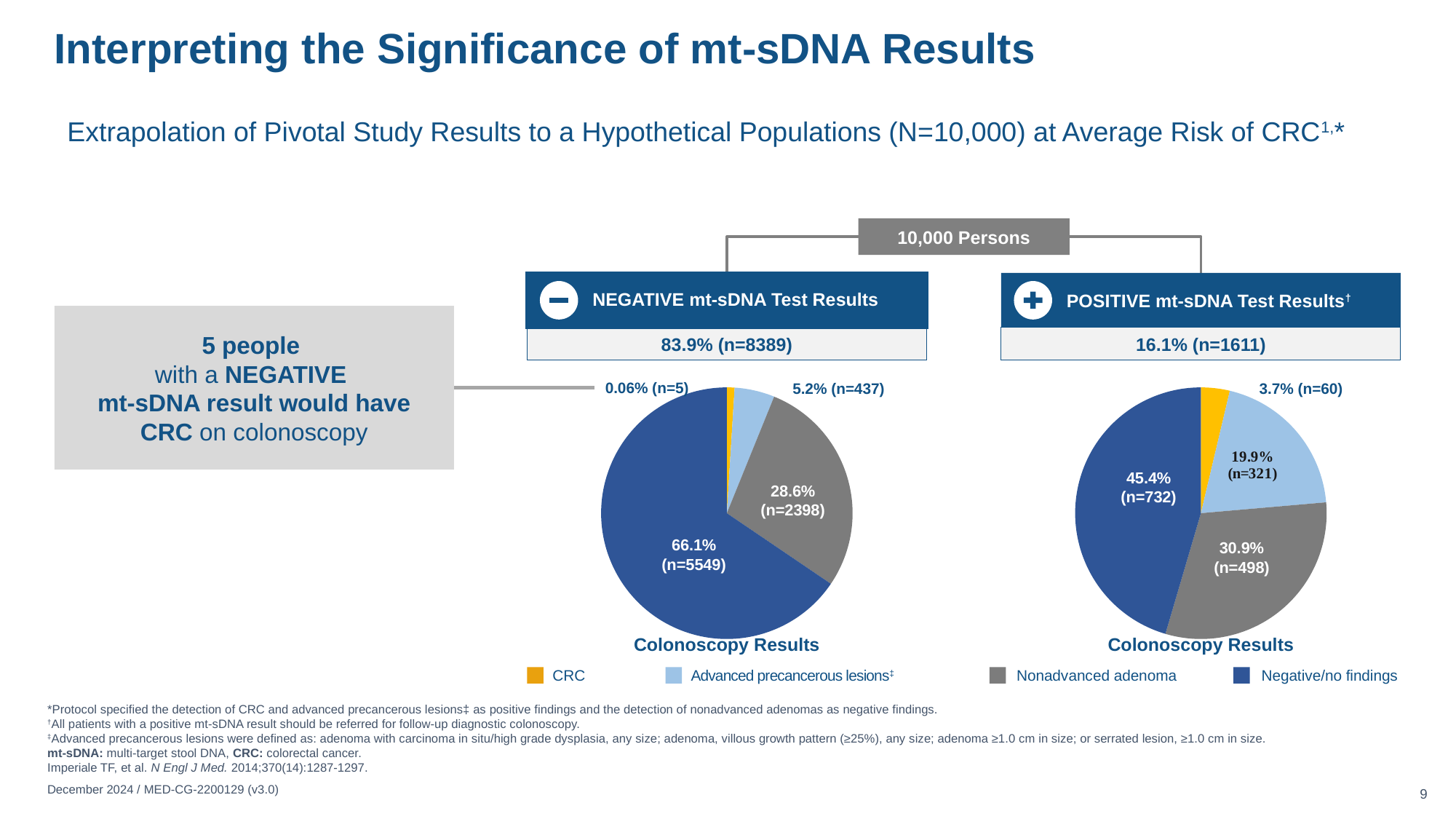
In the POSITIVE mt-sDNA Test Results pie chart, which category has the largest share? Negative/no findings In the NEGATIVE mt-sDNA Test Results pie chart, how many people had CRC on colonoscopy? n=5 In the POSITIVE mt-sDNA Test Results pie chart, what is the difference in percentage points between Negative/no findings and Nonadvanced adenoma? 14.5 How many categories does the legend list for the pie charts? 4 Which is larger: the CRC share in the POSITIVE mt-sDNA pie chart or the CRC share in the NEGATIVE mt-sDNA pie chart? POSITIVE mt-sDNA pie chart What colour represents CRC in the pie charts? Yellow/orange In the POSITIVE mt-sDNA Test Results pie chart, what percentage of colonoscopy results were Nonadvanced adenoma? 30.9% In the NEGATIVE mt-sDNA Test Results pie chart, what percentage of colonoscopy results were Negative/no findings? 66.1% In the NEGATIVE mt-sDNA Test Results pie chart, which category has the smallest share? CRC In the POSITIVE mt-sDNA Test Results pie chart, how many people had Advanced precancerous lesions? n=321 What is the number of persons shown in the NEGATIVE mt-sDNA Test Results group? n=8389 What kind of charts are shown on the slide? Pie charts